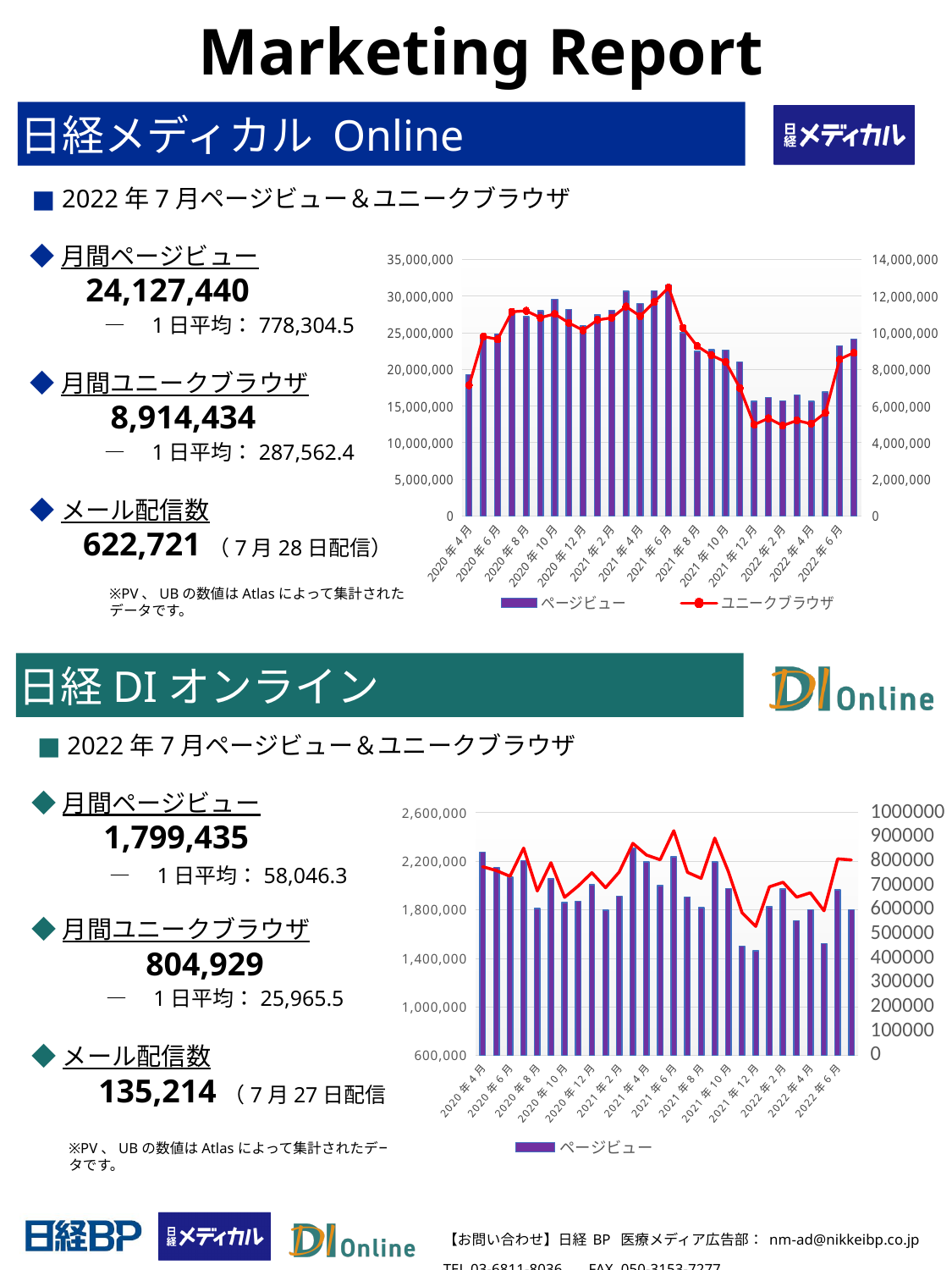
In the 日経 DI オンライン chart, which has the larger ページビュー value, 2021年4月 or 2021年12月? 2021年4月 How many series does the legend of the 日経メディカル Online chart list? 2 What kind of chart is shown in the 日経メディカル Online section? A combined bar and line chart In the 日経メディカル Online chart, which series is drawn as a red line? ユニークブラウザ In the 日経メディカル Online chart, do the ページビュー values rise or fall from 2021年6月 to 2021年12月? fall In the 日経 DI オンライン chart, is the ページビュー value for 2021年12月 greater or less than 1,800,000? less In the 日経メディカル Online chart, is the ページビュー value for 2022年2月 greater or less than 20,000,000? less In the 日経メディカル Online chart, is the ユニークブラウザ value for 2020年4月 greater or less than 8,000,000? less What is the maximum value shown on the left axis of the 日経メディカル Online chart? 35,000,000 How many series does the legend of the 日経 DI オンライン chart list? 1 In the 日経メディカル Online chart, which has the larger ページビュー value, 2021年6月 or 2022年2月? 2021年6月